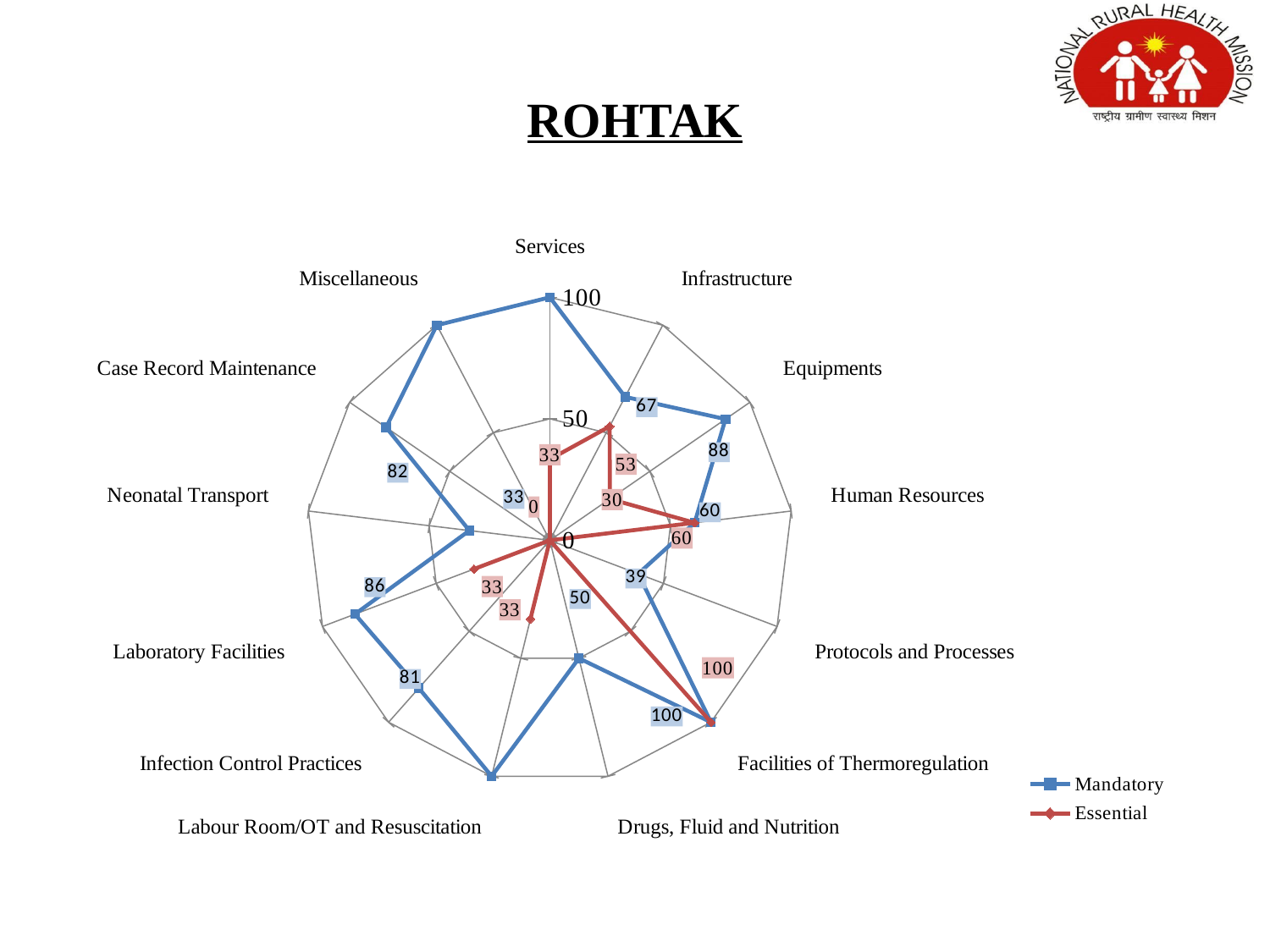
How many categories are plotted around the radar chart? 13 What is the difference between the Mandatory values for Equipments and Infrastructure? 21 What is the Mandatory value for Equipments? 88 Which is larger, the Mandatory value for Laboratory Facilities or for Infection Control Practices? Laboratory Facilities What is the Mandatory value for Laboratory Facilities? 86 Which series is drawn in red on the chart? Essential What is the Mandatory value for Infrastructure? 67 What is the Essential value for Infrastructure? 53 What is the Mandatory value for Protocols and Processes? 39 What is the Essential value for Facilities of Thermoregulation? 100 What kind of chart is shown on the slide? Radar chart How many series does the legend list? 2